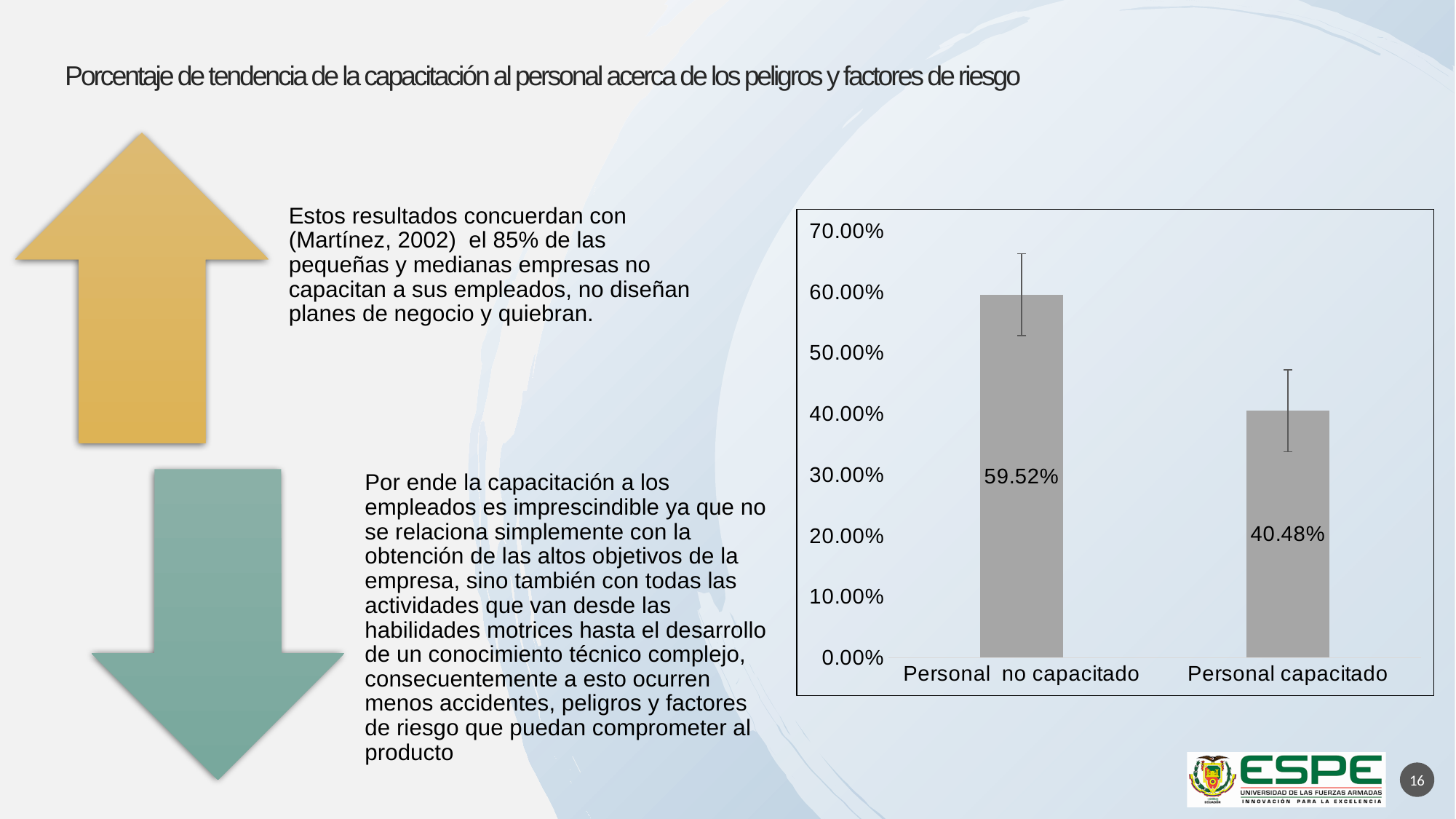
What is the highest value shown on the chart's vertical axis? 70.00% What colour are the bars in the chart? grey Which is larger, the value for Personal no capacitado or Personal capacitado? Personal no capacitado How many categories are shown on the chart? 2 What is the difference between the values for Personal no capacitado and Personal capacitado? 19.04% What kind of chart is shown on the slide? bar chart Is the value for Personal capacitado greater or less than 50.00%? less Is the value for Personal no capacitado greater or less than 50.00%? greater What is the value for Personal no capacitado? 59.52% What is the value for Personal capacitado? 40.48% Which category has the lowest value? Personal capacitado Which category has the highest value? Personal no capacitado